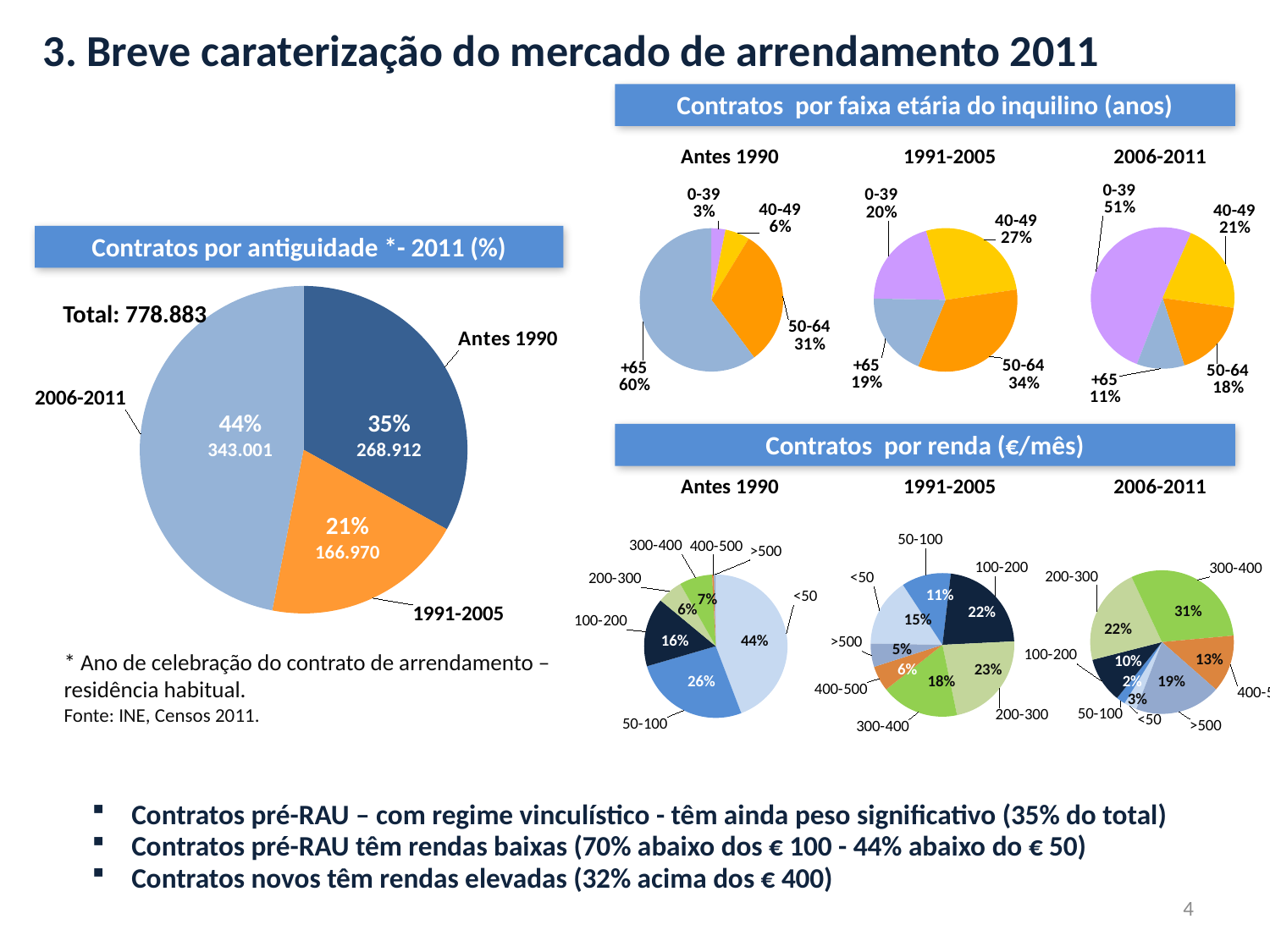
In the 'Contratos por renda' charts, which rent band is the largest in the '2006-2011' pie? 300-400 In the 'Contratos por faixa etária do inquilino' charts, what share of '1991-2005' contracts have tenants aged 50-64? 34% In the 'Contratos por antiguidade' pie chart, how many contracts are in the '2006-2011' slice? 343.001 What total number of contracts is shown next to the 'Contratos por antiguidade' pie chart? 778.883 In the 'Contratos por faixa etária do inquilino' charts, what share of 'Antes 1990' contracts have tenants aged +65? 60% What kind of charts are used on this slide? Pie charts In the 'Contratos por antiguidade' pie chart, what percentage of contracts are from 'Antes 1990'? 35% In the 'Contratos por faixa etária do inquilino' charts, is the +65 share larger in the 'Antes 1990' pie or the '2006-2011' pie? Antes 1990 In the 'Contratos por renda' charts, what share of 'Antes 1990' contracts have a rent below 50 €/month? 44% In the 'Contratos por faixa etária do inquilino' charts, which age group is the largest in the '2006-2011' pie? 0-39 In the 'Contratos por antiguidade' pie chart, what is the difference in percentage points between the '2006-2011' and '1991-2005' slices? 23 In the 'Contratos por antiguidade' pie chart, which period has the smallest share of contracts? 1991-2005